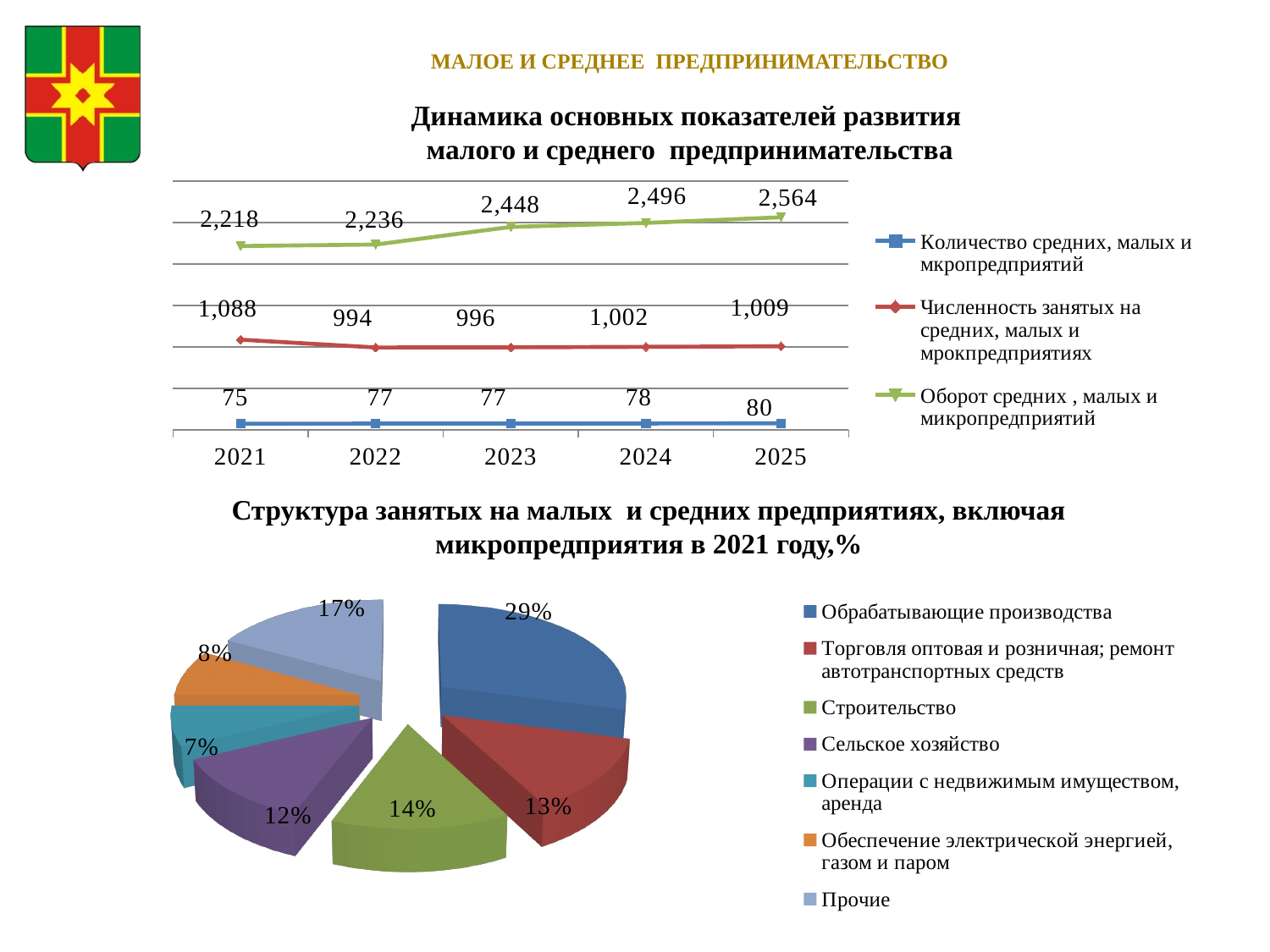
In the line chart 'Динамика основных показателей развития малого и среднего предпринимательства', does 'Оборот средних, малых и микропредприятий' rise or fall from 2021 to 2025? rise How many years are shown on the x axis of the line chart 'Динамика основных показателей развития малого и среднего предпринимательства'? 5 In the pie chart 'Структура занятых на малых и средних предприятиях, включая микропредприятия в 2021 году,%', what share does 'Обрабатывающие производства' have? 29% In the line chart 'Динамика основных показателей развития малого и среднего предпринимательства', what is the value of 'Численность занятых на средних, малых и мрокпредприятиях' in 2022? 994 In the line chart 'Динамика основных показателей развития малого и среднего предпринимательства', what is the value of 'Количество средних, малых и мкропредприятий' in 2024? 78 In the pie chart 'Структура занятых на малых и средних предприятиях, включая микропредприятия в 2021 году,%', which category has the smallest share? Операции с недвижимым имуществом, аренда What kind of chart is the lower chart on the slide, 'Структура занятых на малых и средних предприятиях, включая микропредприятия в 2021 году,%'? pie chart In the line chart 'Динамика основных показателей развития малого и среднего предпринимательства', in which year is 'Численность занятых на средних, малых и мрокпредприятиях' highest? 2021 In the pie chart 'Структура занятых на малых и средних предприятиях, включая микропредприятия в 2021 году,%', which is larger: 'Строительство' or 'Сельское хозяйство'? Строительство How many series does the legend of the line chart 'Динамика основных показателей развития малого и среднего предпринимательства' list? 3 In the line chart 'Динамика основных показателей развития малого и среднего предпринимательства', what is the value of 'Оборот средних, малых и микропредприятий' in 2025? 2,564 In the line chart 'Динамика основных показателей развития малого и среднего предпринимательства', by how much does 'Оборот средних, малых и микропредприятий' in 2025 exceed its value in 2021? 346